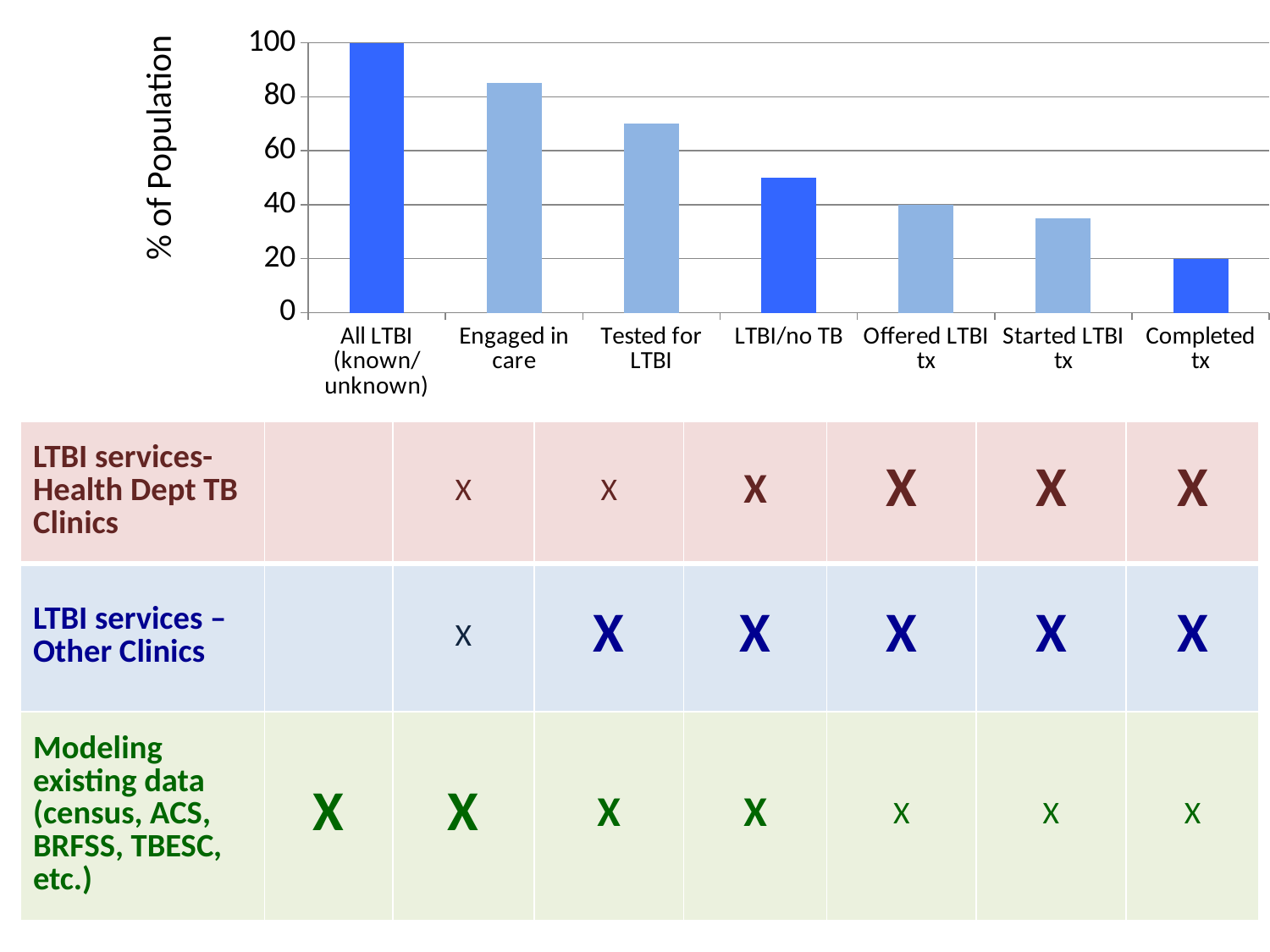
What kind of chart is shown on the slide? bar chart Which category has the highest value in the chart? All LTBI (known/unknown) Which is larger, the value for Tested for LTBI or the value for LTBI/no TB? Tested for LTBI What is the value for All LTBI (known/unknown)? 100 Is the value for Started LTBI tx greater or less than 40? less Is the value for Engaged in care greater or less than 80? greater What is the label of the y axis of the chart? % of Population Do the values rise or fall from left to right along the x axis? fall How many categories are shown on the x axis of the chart? 7 What is the value for Completed tx? 20 What is the value for Offered LTBI tx? 40 Which category has the lowest value in the chart? Completed tx